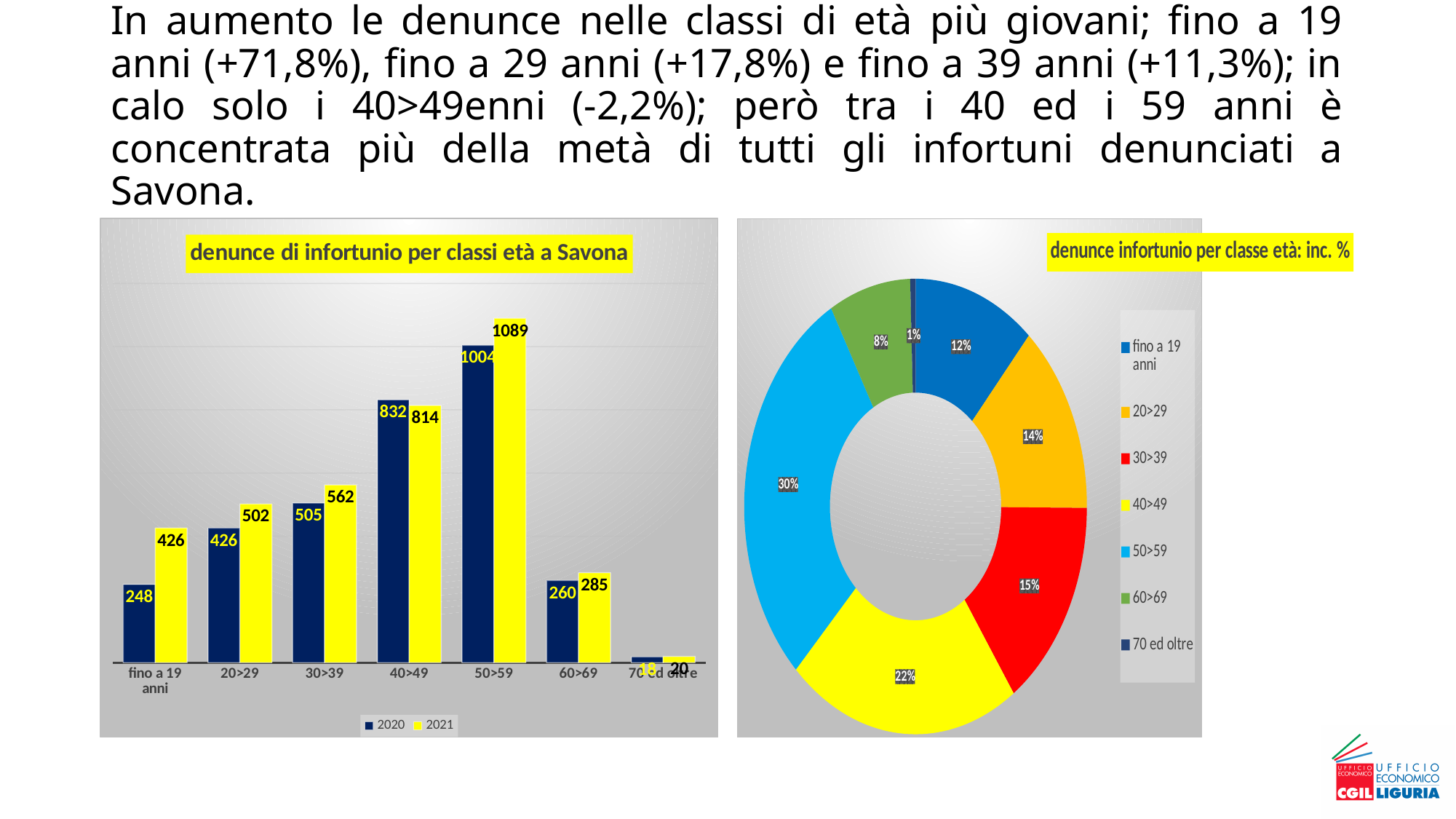
In the chart 'denunce di infortunio per classi età a Savona', what is the 2020 value for 'fino a 19 anni'? 248 In the chart 'denunce di infortunio per classi età a Savona', what is the difference between the 2021 and 2020 values for 'fino a 19 anni'? 178 In the chart 'denunce di infortunio per classi età a Savona', which is larger for the 40>49 class: the 2020 value or the 2021 value? 2020 In the chart 'denunce di infortunio per classi età a Savona', which age class has the highest 2021 value? 50>59 In the chart 'denunce infortunio per classe età: inc. %', what share does the 50>59 class have? 30% How many series does the legend of the chart 'denunce di infortunio per classi età a Savona' list? 2 In the chart 'denunce infortunio per classe età: inc. %', what colour is the 30>39 segment? red How many age classes are shown on the x axis of the chart 'denunce di infortunio per classi età a Savona'? 7 In the chart 'denunce infortunio per classe età: inc. %', what is the share of the 40>49 class? 22% In the chart 'denunce infortunio per classe età: inc. %', which age class has the smallest share? 70 ed oltre What kind of chart is 'denunce di infortunio per classi età a Savona'? bar chart In the chart 'denunce di infortunio per classi età a Savona', what is the 2021 value for the 50>59 age class? 1089